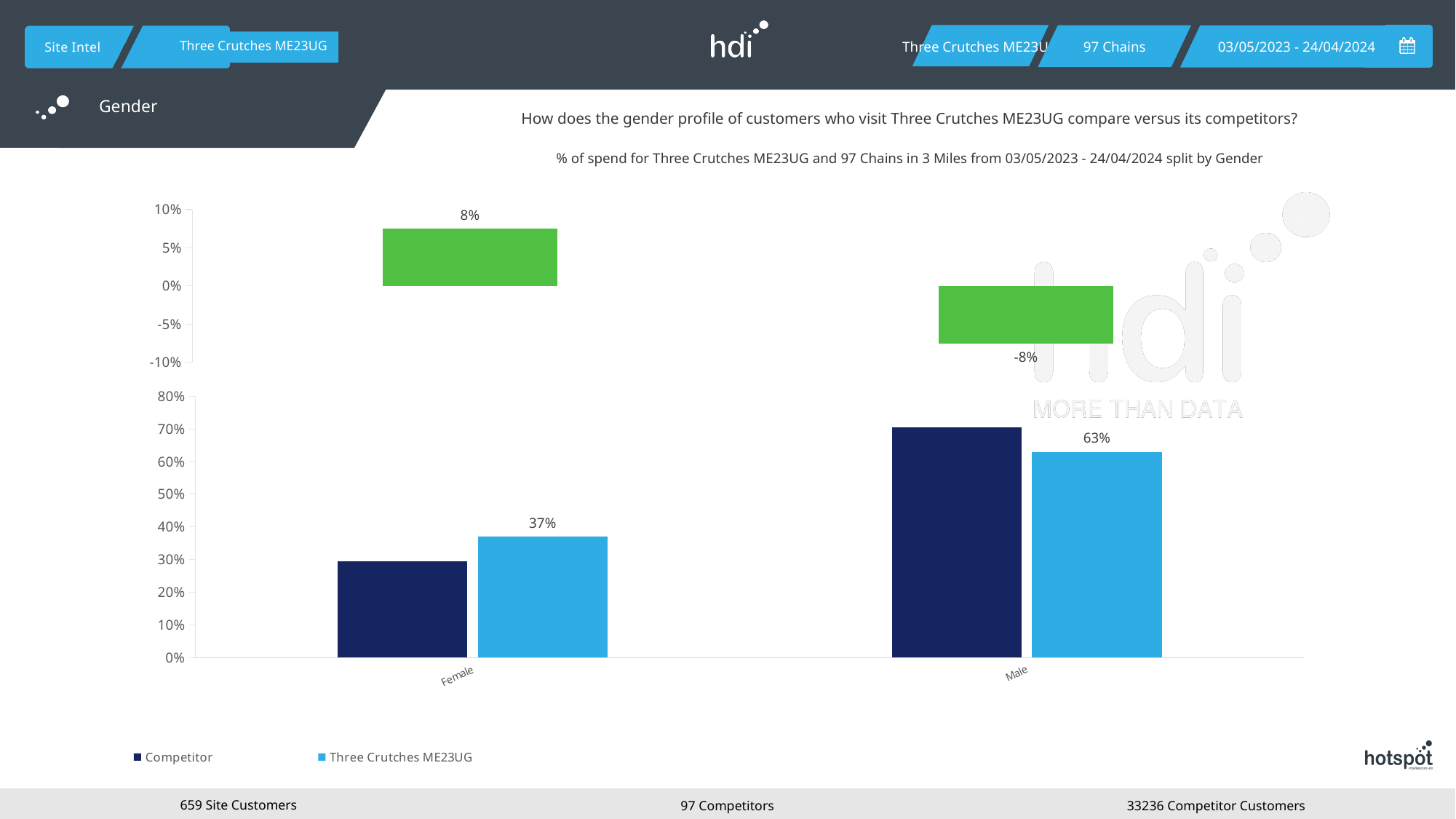
In the bottom bar chart, for Female, which is larger: the Competitor bar or the Three Crutches ME23UG bar? Three Crutches ME23UG In the bottom bar chart, which gender category has the higher value for Three Crutches ME23UG? Male In the bottom bar chart, what is the difference between the Three Crutches ME23UG values for Male and Female? 26% In the bottom bar chart, what is the value for Three Crutches ME23UG for Male? 63% How many series does the legend of the bottom bar chart list? 2 In the bottom bar chart, what is the value for Three Crutches ME23UG for Female? 37% In the bottom bar chart, for Male, which is larger: the Competitor bar or the Three Crutches ME23UG bar? Competitor In the top chart, what is the value shown for Male? -8% What type of chart is the bottom chart? Bar chart In the top chart, what is the value shown for Female? 8%